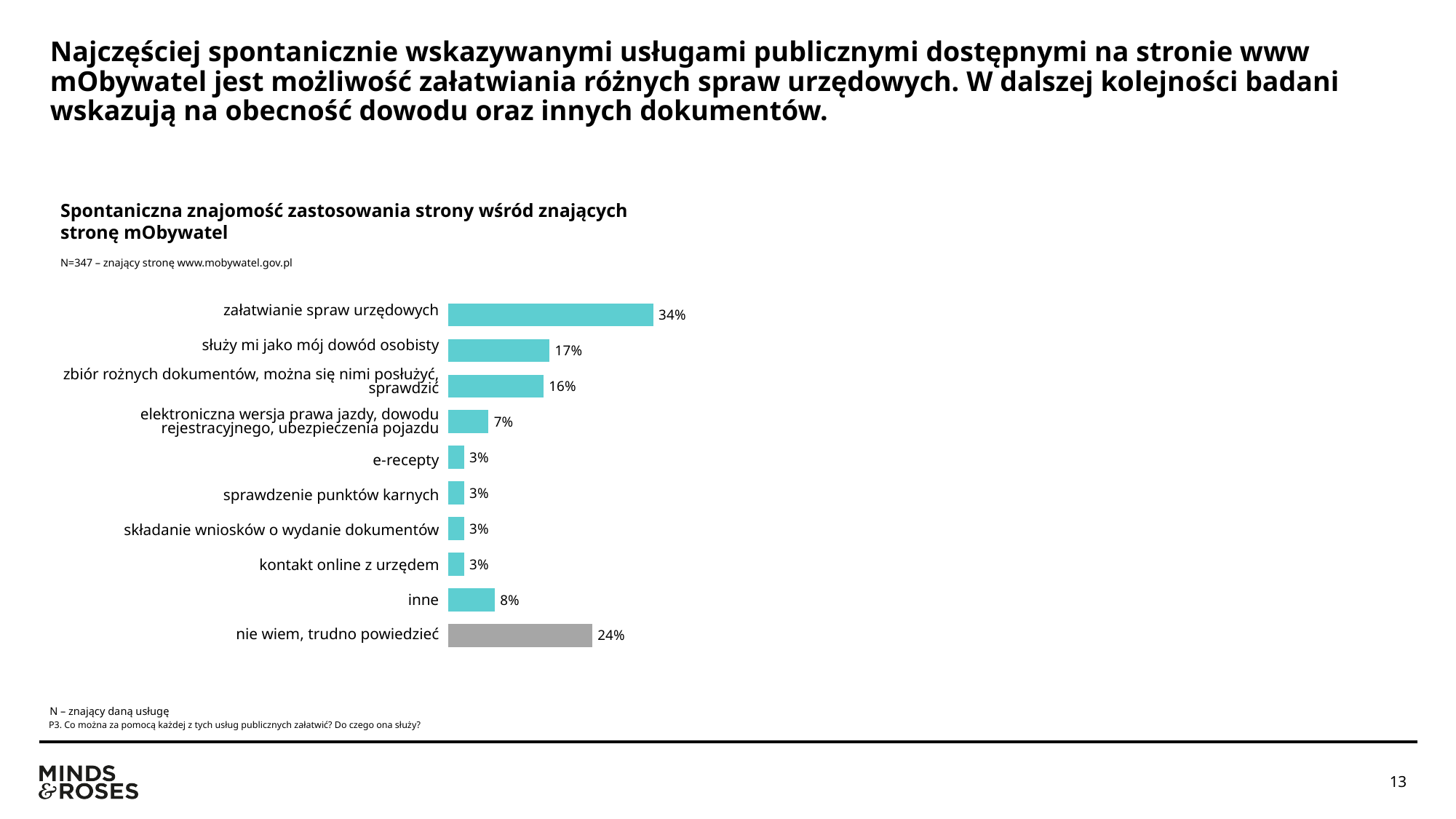
What kind of chart is shown on the slide? bar chart Which is larger: "inne" or "e-recepty"? inne What is the difference between "załatwianie spraw urzędowych" and "służy mi jako mój dowód osobisty"? 17% How many categories are shown in the chart? 10 What is the value for "służy mi jako mój dowód osobisty"? 17% What is the value for "załatwianie spraw urzędowych"? 34% What is the sample size (N) stated under the chart title? N=347 What is the value for "inne"? 8% Which category has the highest value? załatwianie spraw urzędowych What is the value for "elektroniczna wersja prawa jazdy, dowodu rejestracyjnego, ubezpieczenia pojazdu"? 7% What is the difference between "nie wiem, trudno powiedzieć" and "zbiór rożnych dokumentów, można się nimi posłużyć, sprawdzić"? 8% What is the value for "nie wiem, trudno powiedzieć"? 24%